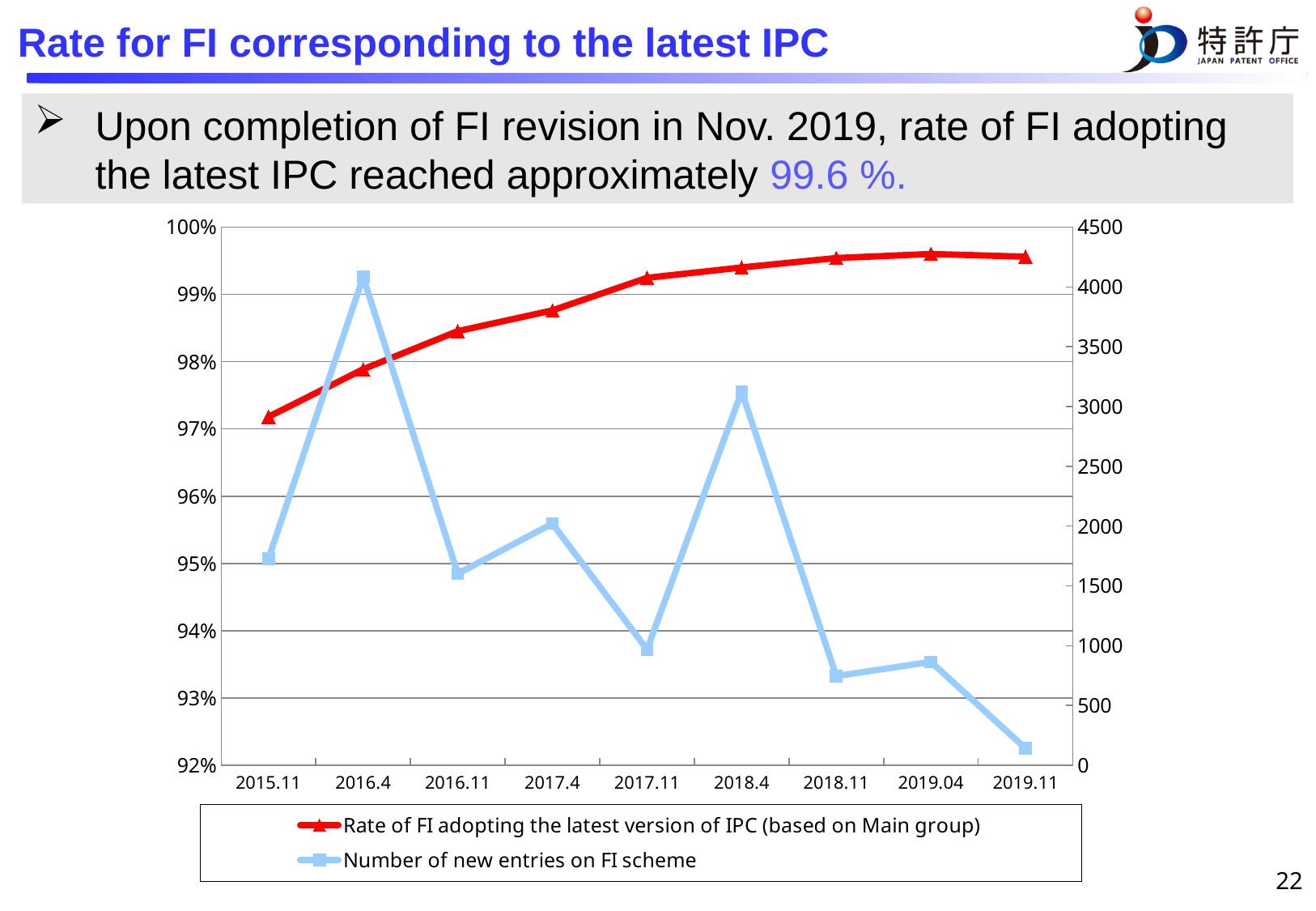
Is the Number of new entries on FI scheme at 2019.11 greater or less than 500? less Is the Number of new entries on FI scheme at 2016.4 greater or less than 3500? greater Is the Rate of FI adopting the latest version of IPC at 2017.11 greater or less than 99%? greater Which series is drawn in red with triangle markers? Rate of FI adopting the latest version of IPC (based on Main group) How many time points are plotted along the x axis? 9 Does the Rate of FI adopting the latest version of IPC rise or fall from 2015.11 to 2019.04? rise At which time point is the Number of new entries on FI scheme highest? 2016.4 What kind of chart is shown on the slide? line chart At which time point is the Number of new entries on FI scheme lowest? 2019.11 At which time point is the Rate of FI adopting the latest version of IPC lowest? 2015.11 How many series does the legend list? 2 Which has the larger Number of new entries on FI scheme, 2016.4 or 2018.4? 2016.4